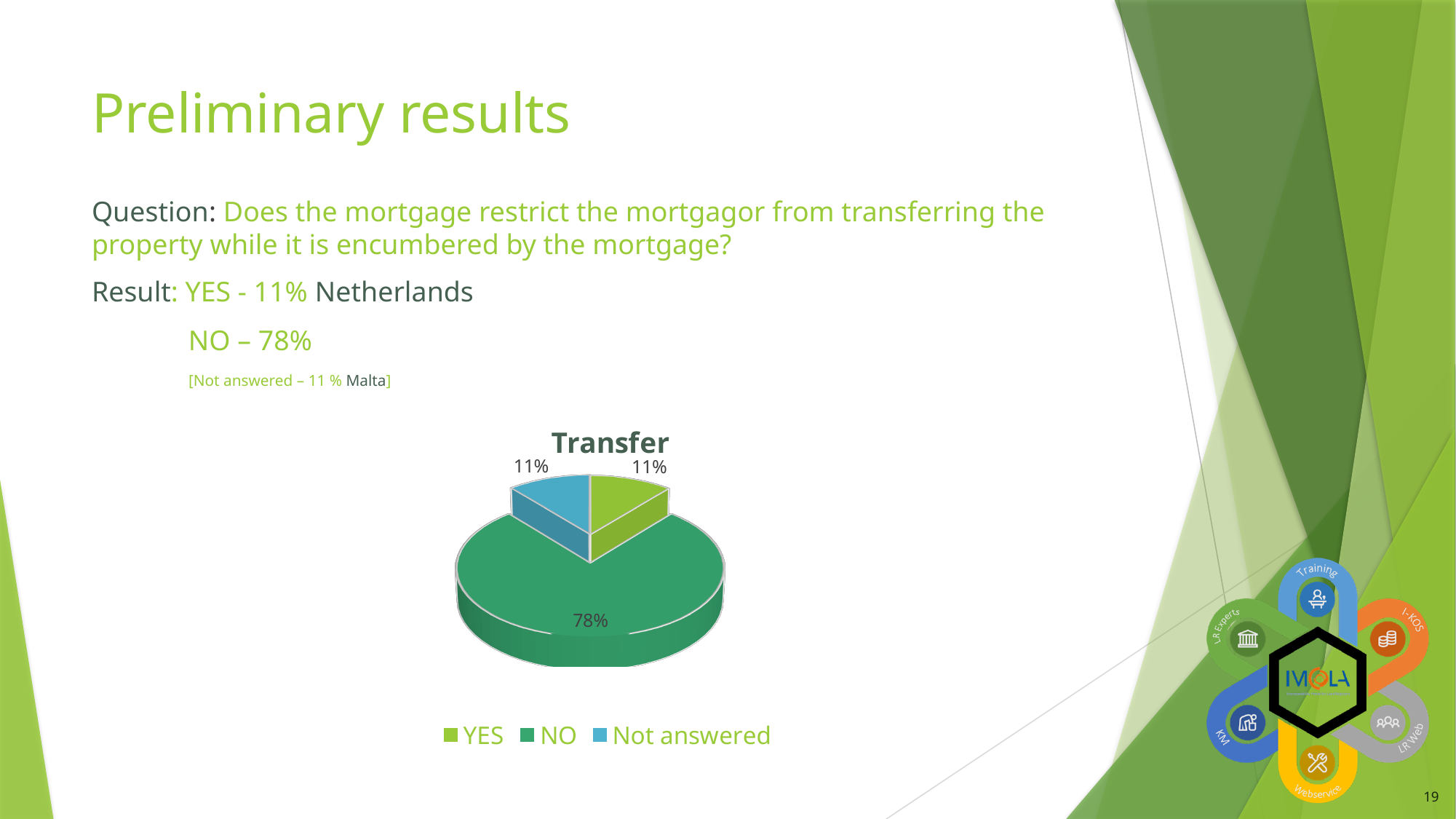
Which is larger, the NO slice or the Not answered slice? NO What is the title of the chart? Transfer What is the combined share of YES and Not answered? 22% How many categories does the legend list? 3 What type of chart is shown on the slide? pie chart Which legend entry is shown in light blue? Not answered What share of the pie does NO represent? 78% What share of the pie does YES represent? 11% What is the difference between the NO share and the YES share? 67% Is the value for NO greater or less than 50%? greater Which category has the largest slice of the pie? NO What share of the pie does Not answered represent? 11%